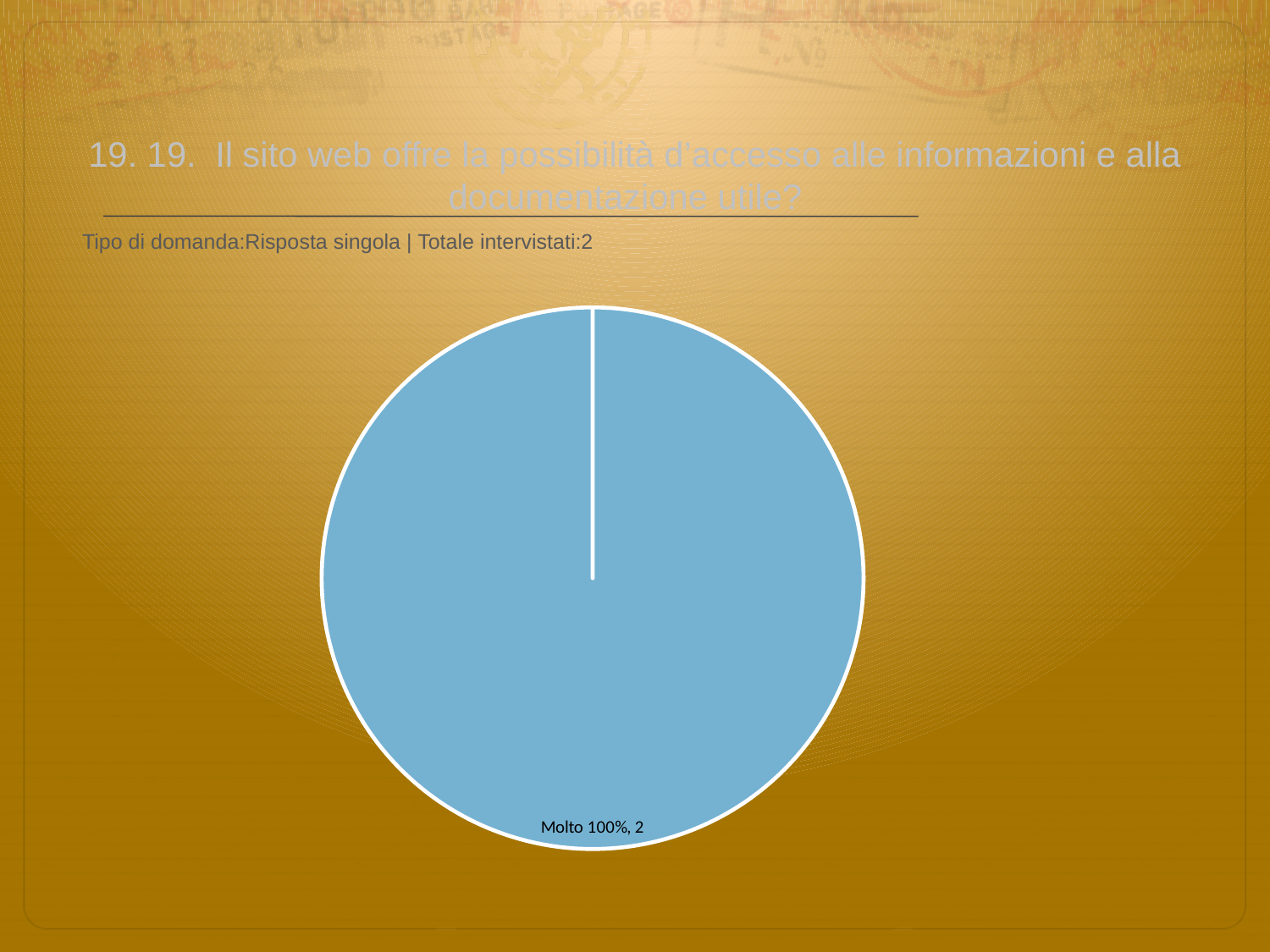
Which category is the largest slice of the pie chart? Molto What count is shown in the data label for the "Molto" slice? 2 What is the total number of respondents (Totale intervistati) stated on the slide? 2 What colour is the "Molto" slice of the pie chart? light blue What share of the pie does the "Molto" slice represent? 100% How many slices does the pie chart have? 1 What kind of chart is shown on the slide? pie chart Is the share for "Molto" greater or less than 50%? greater